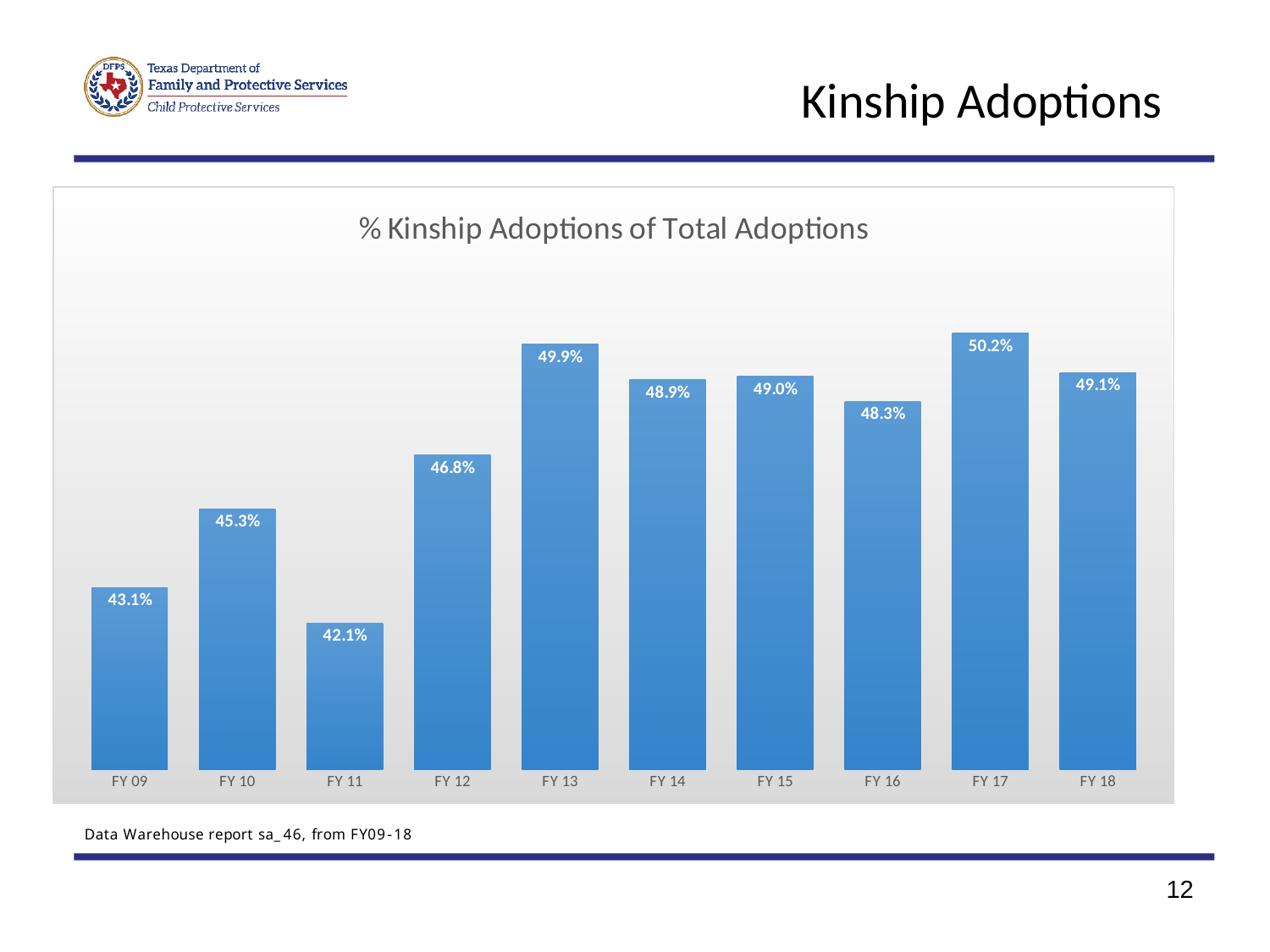
Which fiscal year has the highest percentage of kinship adoptions? FY 17 How many fiscal years are shown on the chart? 10 Do the values generally rise or fall from FY 09 to FY 13? Rise What is the difference between the values for FY 12 and FY 10? 1.5% Which is larger, the value for FY 12 or the value for FY 14? FY 14 What is the value for FY 13? 49.9% Which fiscal year has the lowest percentage of kinship adoptions? FY 11 What is the value for FY 09? 43.1% What is the value for FY 16? 48.3% What is the title of the chart? % Kinship Adoptions of Total Adoptions What kind of chart is shown on the slide? Bar chart What is the difference between the values for FY 17 and FY 11? 8.1%